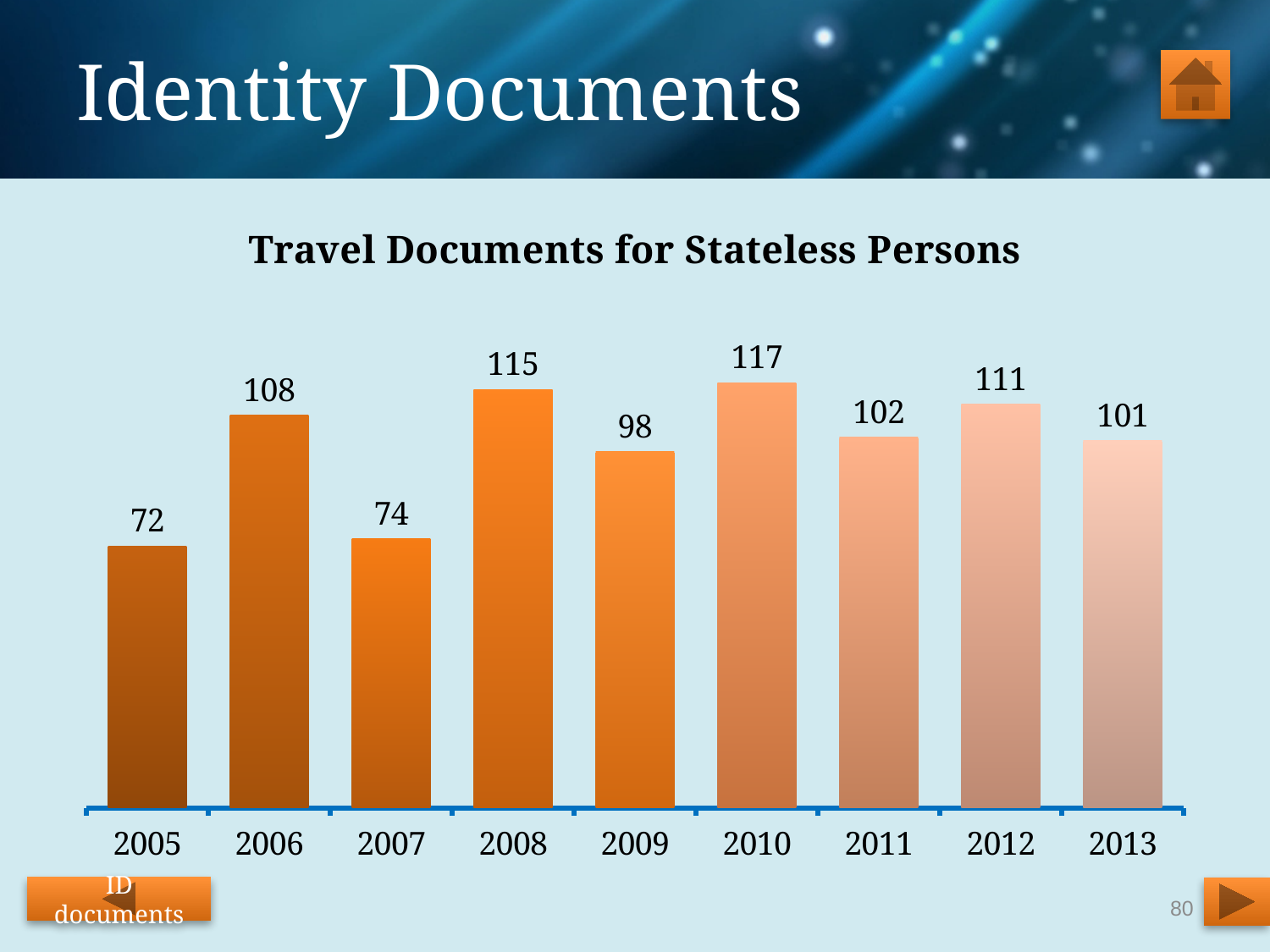
How many years are shown on the x axis? 9 Which year has the lowest value? 2005 What is the title of the chart? Travel Documents for Stateless Persons Which is larger, the value for 2006 or the value for 2012? 2012 Did the value rise or fall from 2012 to 2013? fall What is the difference between the values for 2008 and 2007? 41 Which year has the highest value? 2010 What is the value for 2013? 101 What is the value for 2005? 72 What is the value for 2010? 117 What kind of chart is this? bar chart What is the difference between the values for 2010 and 2005? 45